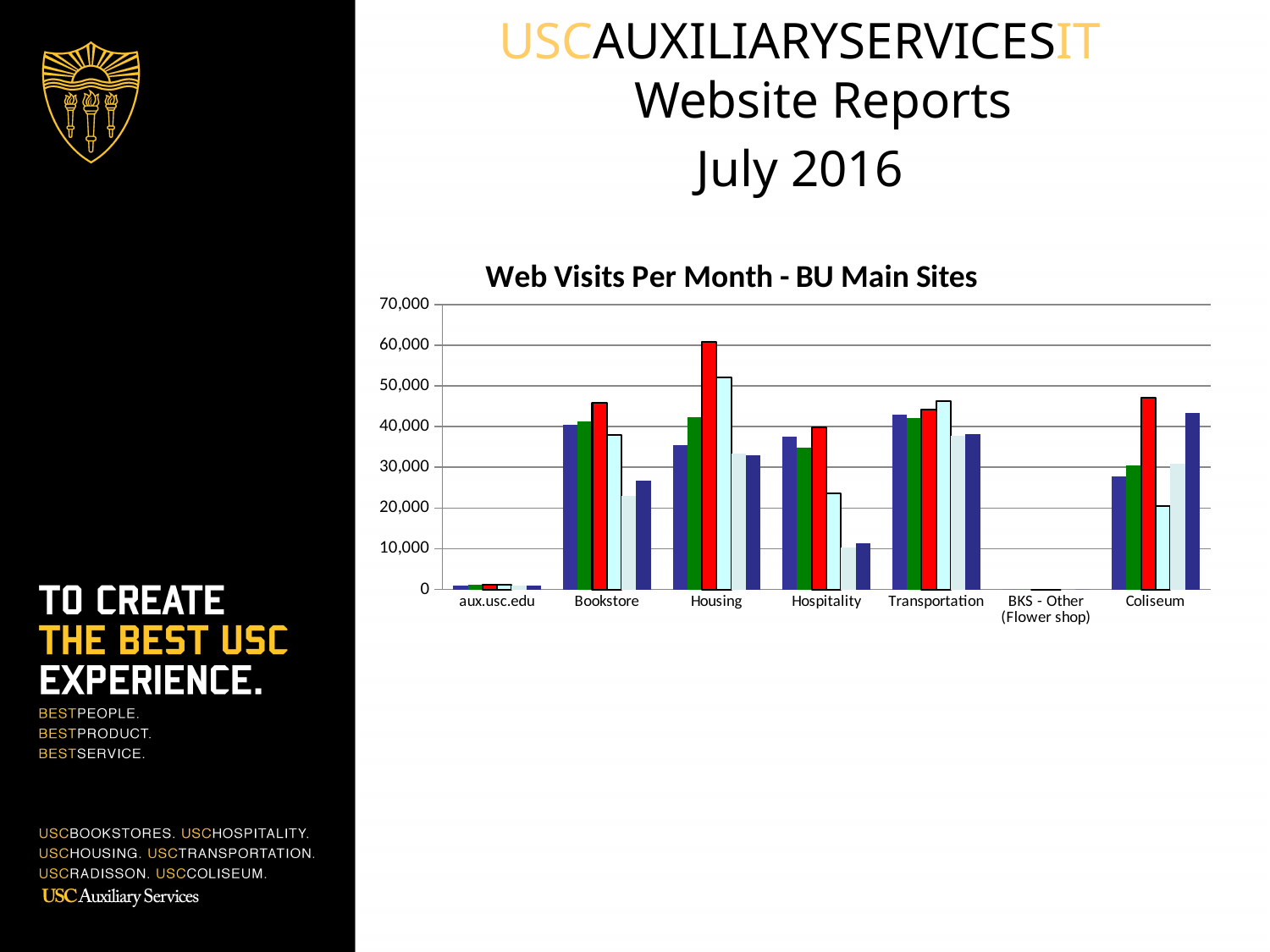
Which category has the tallest bar in the chart? Housing Which is larger, the red bar for Housing or the red bar for Bookstore? Housing Which is larger, the light blue bar for Transportation or the light blue bar for Hospitality? Transportation Are the bars for aux.usc.edu greater or less than 10,000? less Is the red bar for Coliseum greater or less than 40,000? greater What is the title of the chart on the slide? Web Visits Per Month - BU Main Sites How many categories are shown along the x axis of the chart? 7 Is the red bar for Housing greater or less than 50,000? greater What is the highest value shown on the y axis of the chart? 70,000 What kind of chart is shown on the slide? bar chart